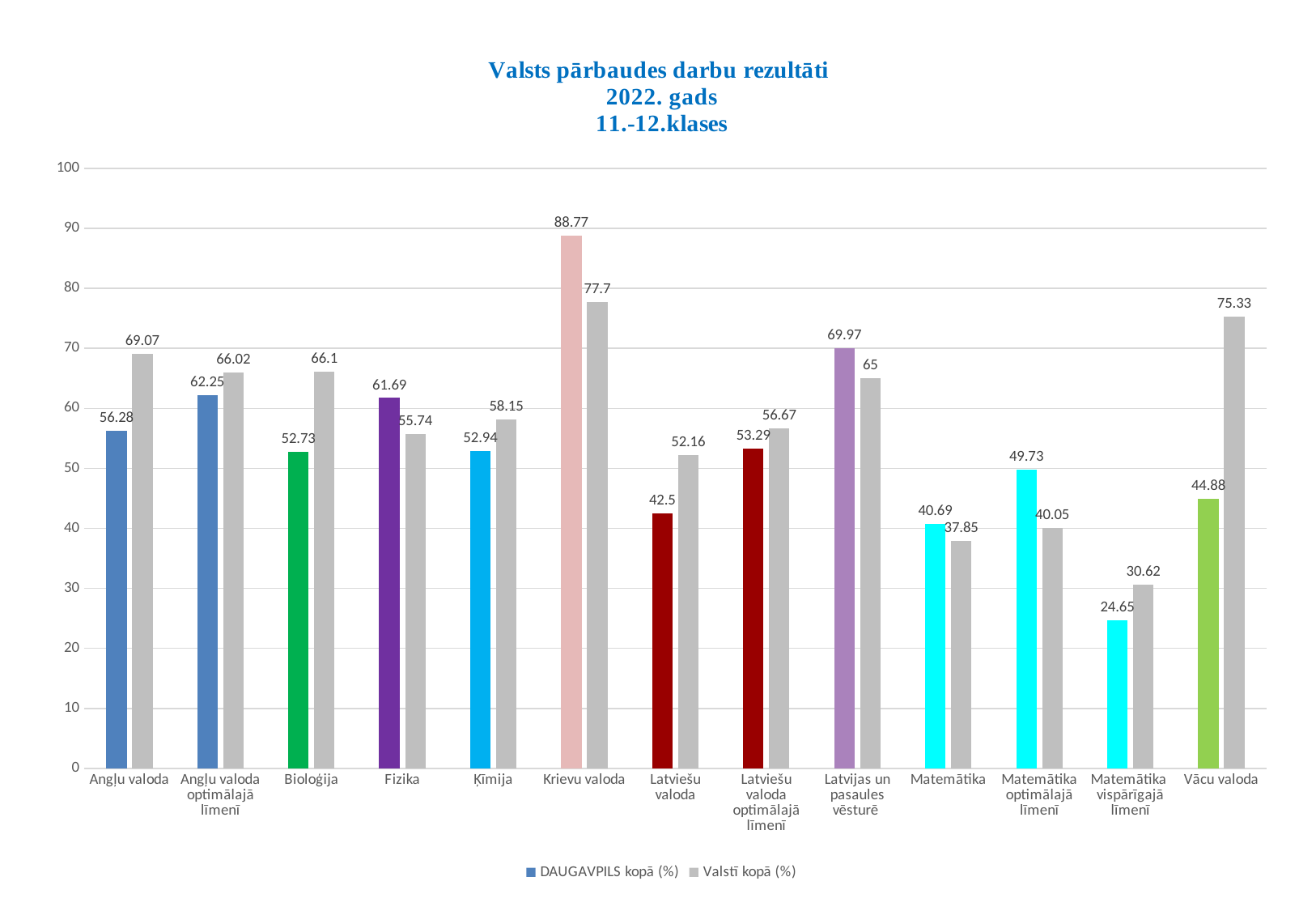
How many subject categories are shown on the x axis? 13 What is the DAUGAVPILS kopā (%) value for Matemātika optimālajā līmenī? 49.73 What is the DAUGAVPILS kopā (%) value for Krievu valoda? 88.77 Which category has the highest DAUGAVPILS kopā (%) value? Krievu valoda What is the title of the chart? Valsts pārbaudes darbu rezultāti 2022. gads 11.-12.klases For Fizika, which is larger: the DAUGAVPILS kopā (%) value or the Valstī kopā (%) value? DAUGAVPILS kopā (%) How many series does the legend list? 2 Is the DAUGAVPILS kopā (%) value for Latviešu valoda greater or less than 50? less What type of chart is shown on the slide? Bar chart Which category has the lowest Valstī kopā (%) value? Matemātika vispārīgajā līmenī What is the difference between the Valstī kopā (%) and DAUGAVPILS kopā (%) values for Vācu valoda? 30.45 What is the Valstī kopā (%) value for Vācu valoda? 75.33